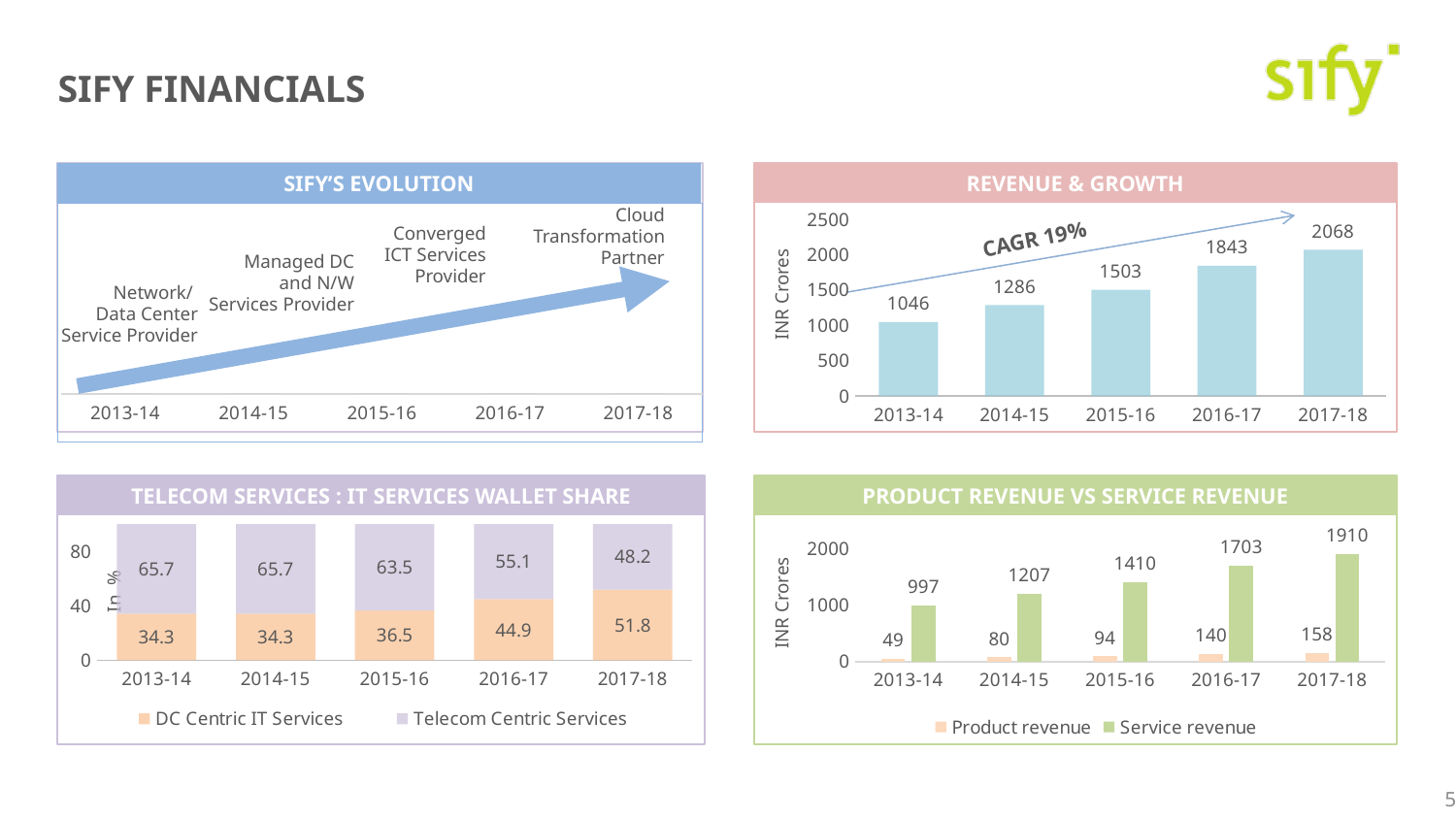
In the 'Product Revenue vs Service Revenue' chart, what is the Service revenue for 2015-16? 1410 In the 'Revenue & Growth' chart, what CAGR is annotated on the chart? CAGR 19% In the 'Product Revenue vs Service Revenue' chart, which is larger in 2017-18: Product revenue or Service revenue? Service revenue In the 'Revenue & Growth' chart, what is the revenue for 2017-18? 2068 In the 'Telecom Services : IT Services Wallet Share' chart, how many series does the legend list? 2 In the 'Revenue & Growth' chart, do the values rise or fall from 2013-14 to 2017-18? rise In the 'Revenue & Growth' chart, what is the difference between the 2016-17 and 2015-16 values? 340 In the 'Telecom Services : IT Services Wallet Share' chart, which year has the highest Telecom Centric Services share? 2013-14 and 2014-15 (65.7) In the 'Revenue & Growth' chart, which year has the lowest revenue? 2013-14 What kind of chart is the 'Product Revenue vs Service Revenue' chart? bar chart In the 'Telecom Services : IT Services Wallet Share' chart, what is the value for DC Centric IT Services in 2016-17? 44.9 In the 'Telecom Services : IT Services Wallet Share' chart, what is the total of the stacked bar for 2017-18? 100